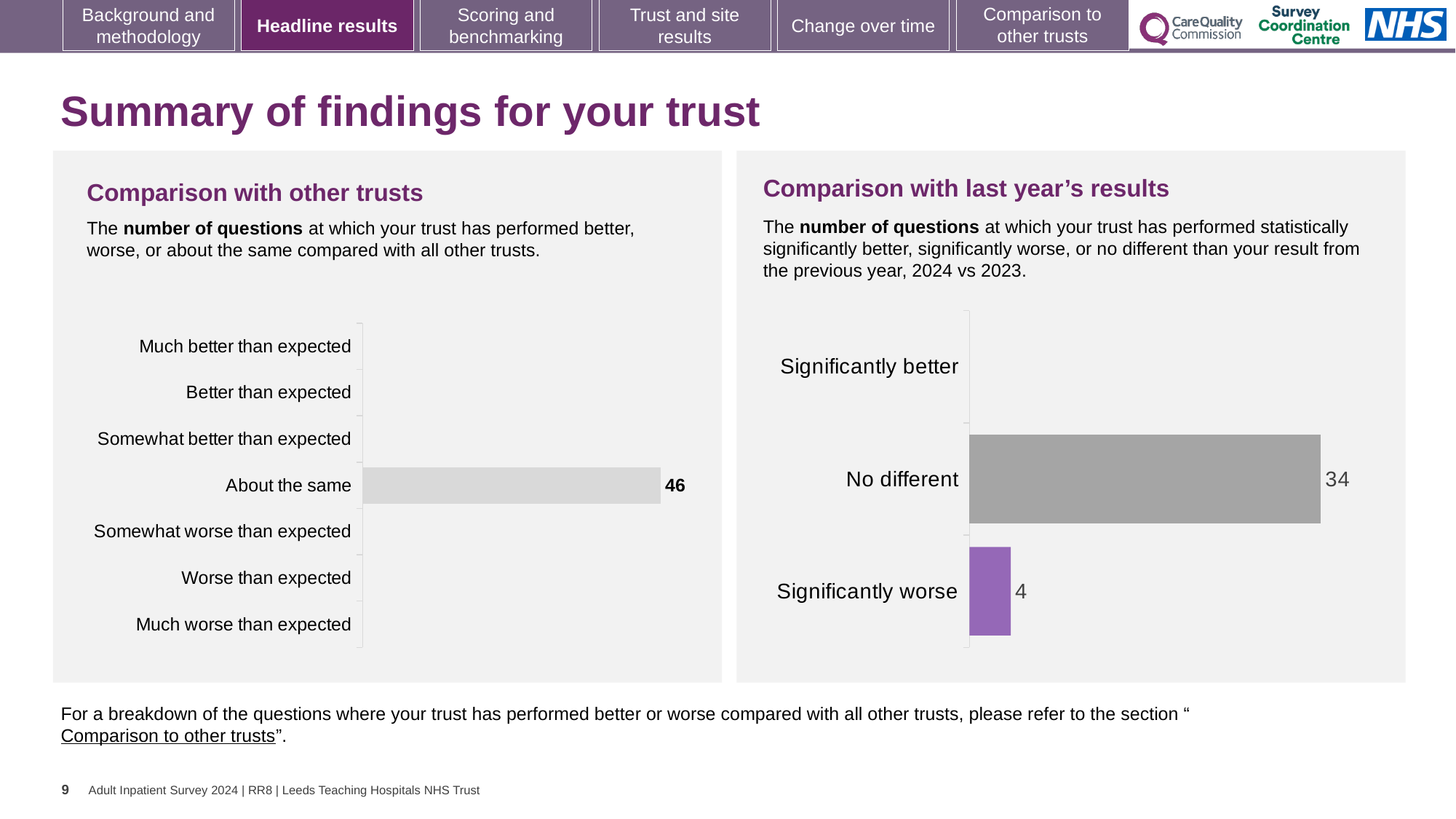
How many categories are listed on the y axis of the 'Comparison with other trusts' chart? 7 In the 'Comparison with last year's results' chart, what is the difference between 'No different' and 'Significantly worse'? 30 In the 'Comparison with last year's results' chart, which category has the highest value? No different In the 'Comparison with other trusts' chart, what is the value for 'About the same'? 46 In the 'Comparison with last year's results' chart, what is the value for 'Significantly worse'? 4 In the 'Comparison with last year's results' chart, what is the value for 'No different'? 34 What kind of chart is the 'Comparison with last year's results' chart? Bar chart How many categories are listed on the y axis of the 'Comparison with last year's results' chart? 3 In the 'Comparison with last year's results' chart, which is larger: 'No different' or 'Significantly worse'? No different In the 'Comparison with other trusts' chart, which category has the highest value? About the same What kind of chart is the 'Comparison with other trusts' chart? Bar chart In the 'Comparison with last year's results' chart, what colour is the 'Significantly worse' bar? Purple